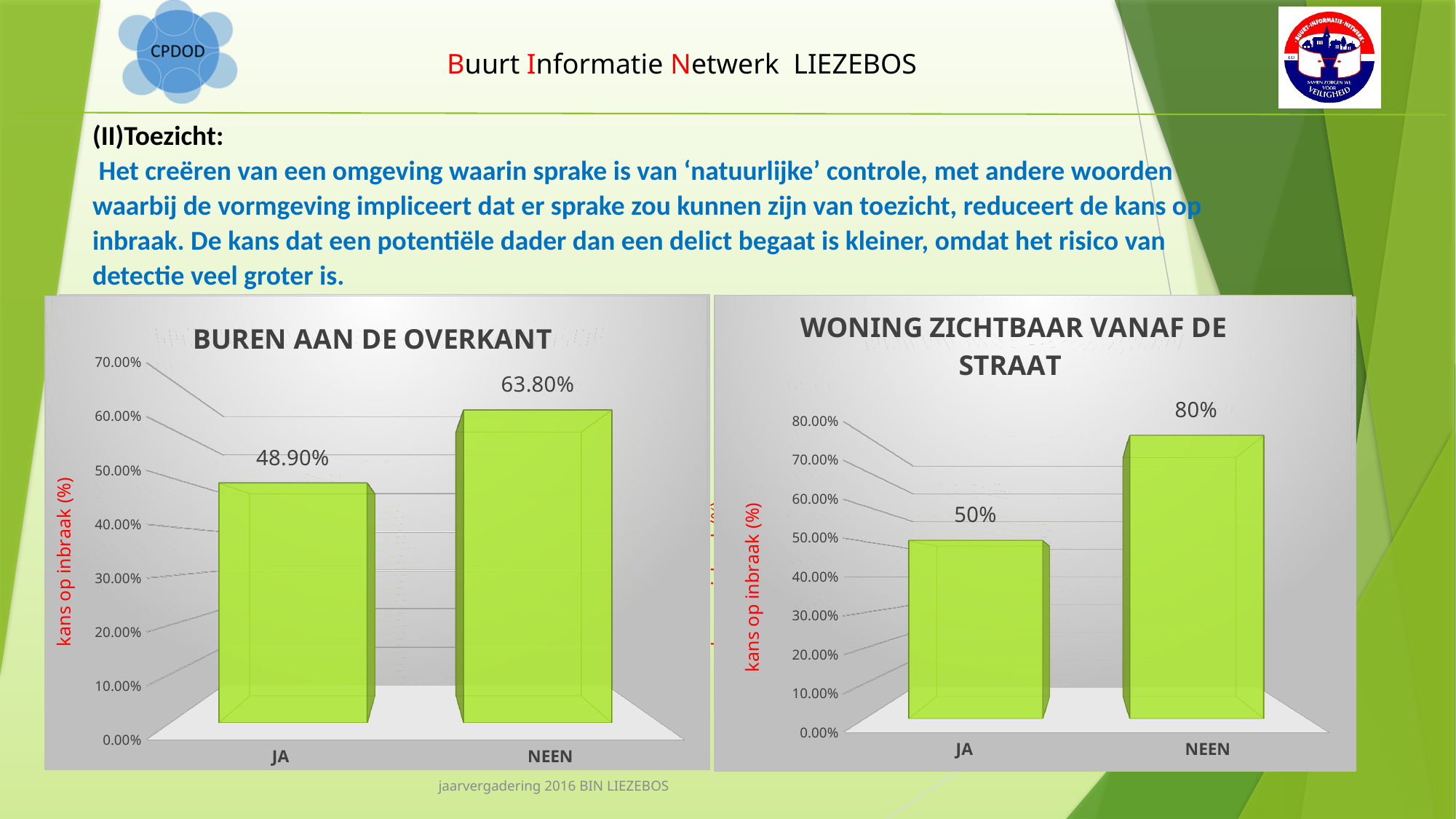
In the 'BUREN AAN DE OVERKANT' chart, which category has the highest value? NEEN In the 'BUREN AAN DE OVERKANT' chart, what is the difference between the NEEN and JA values? 14.90% What is the y-axis label of the 'WONING ZICHTBAAR VANAF DE STRAAT' chart? kans op inbraak (%) In the 'BUREN AAN DE OVERKANT' chart, which is larger, the value for JA or the value for NEEN? NEEN In the 'WONING ZICHTBAAR VANAF DE STRAAT' chart, what is the difference between the NEEN and JA values? 30% What kind of chart is 'BUREN AAN DE OVERKANT'? Bar chart In the 'BUREN AAN DE OVERKANT' chart, what is the value for JA? 48.90% In the 'BUREN AAN DE OVERKANT' chart, what is the value for NEEN? 63.80% In the 'WONING ZICHTBAAR VANAF DE STRAAT' chart, what is the value for NEEN? 80% In the 'WONING ZICHTBAAR VANAF DE STRAAT' chart, which category has the lowest value? JA How many categories are shown in the 'WONING ZICHTBAAR VANAF DE STRAAT' chart? 2 In the 'WONING ZICHTBAAR VANAF DE STRAAT' chart, what is the value for JA? 50%